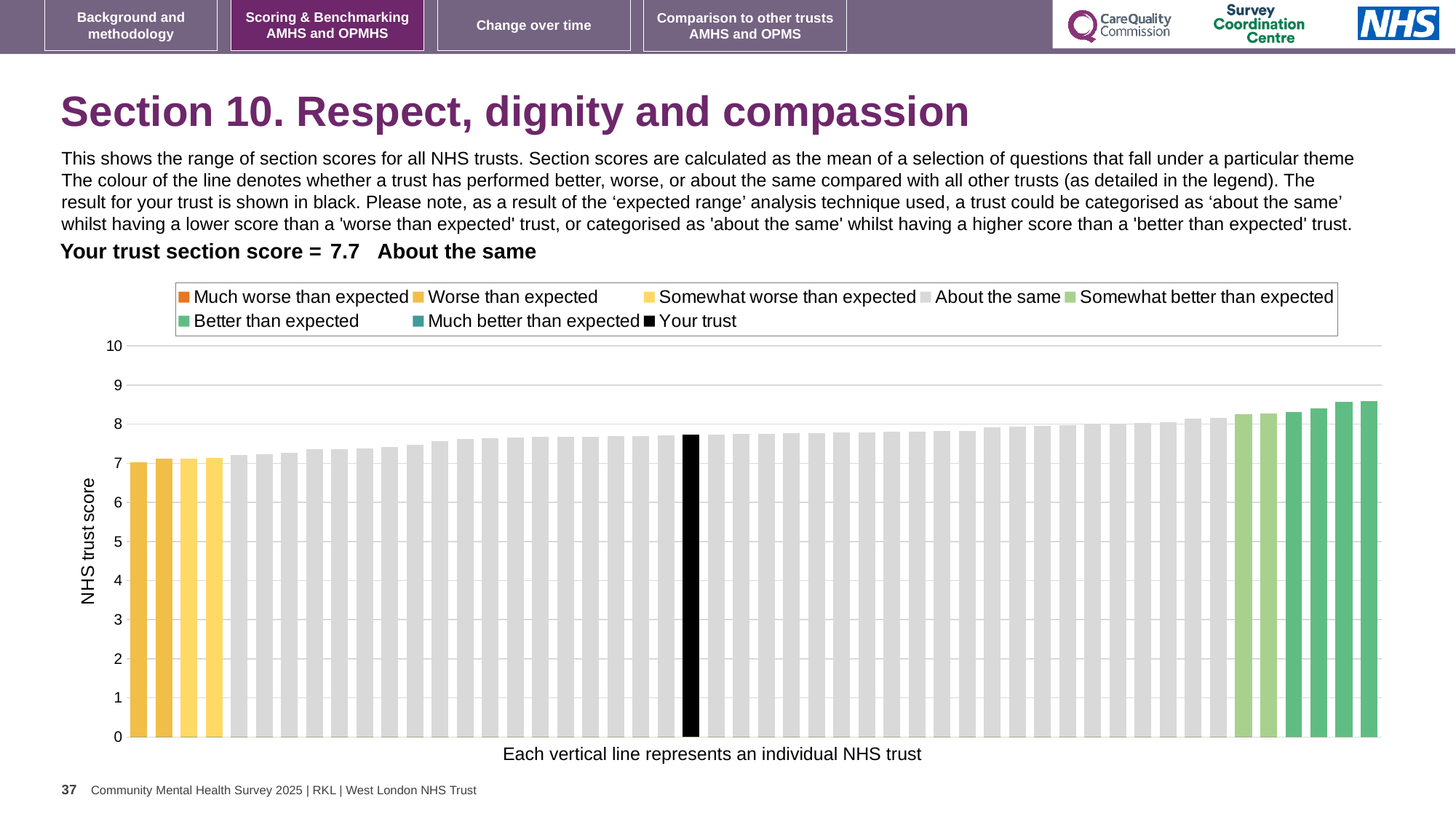
How many bars are coloured as 'Somewhat better than expected' (light green)? 2 Is the value of the rightmost (highest) bar greater or less than 8? greater What is the label on the vertical axis of the chart? NHS trust score What kind of chart is shown on the slide? Bar chart How many bars are coloured as 'Better than expected' (dark green)? 4 Do the bar values rise or fall from left to right along the x axis? Rise What is the section score for your trust shown on the slide? 7.7 How many bars are coloured as 'Much worse than expected' (orange)? 0 Which is larger, the rightmost bar or the black 'Your trust' bar? The rightmost bar Is the value of the leftmost (lowest) bar greater or less than 8? less Is the value for your trust's bar greater or less than 7? greater How many entries does the chart legend list? 8